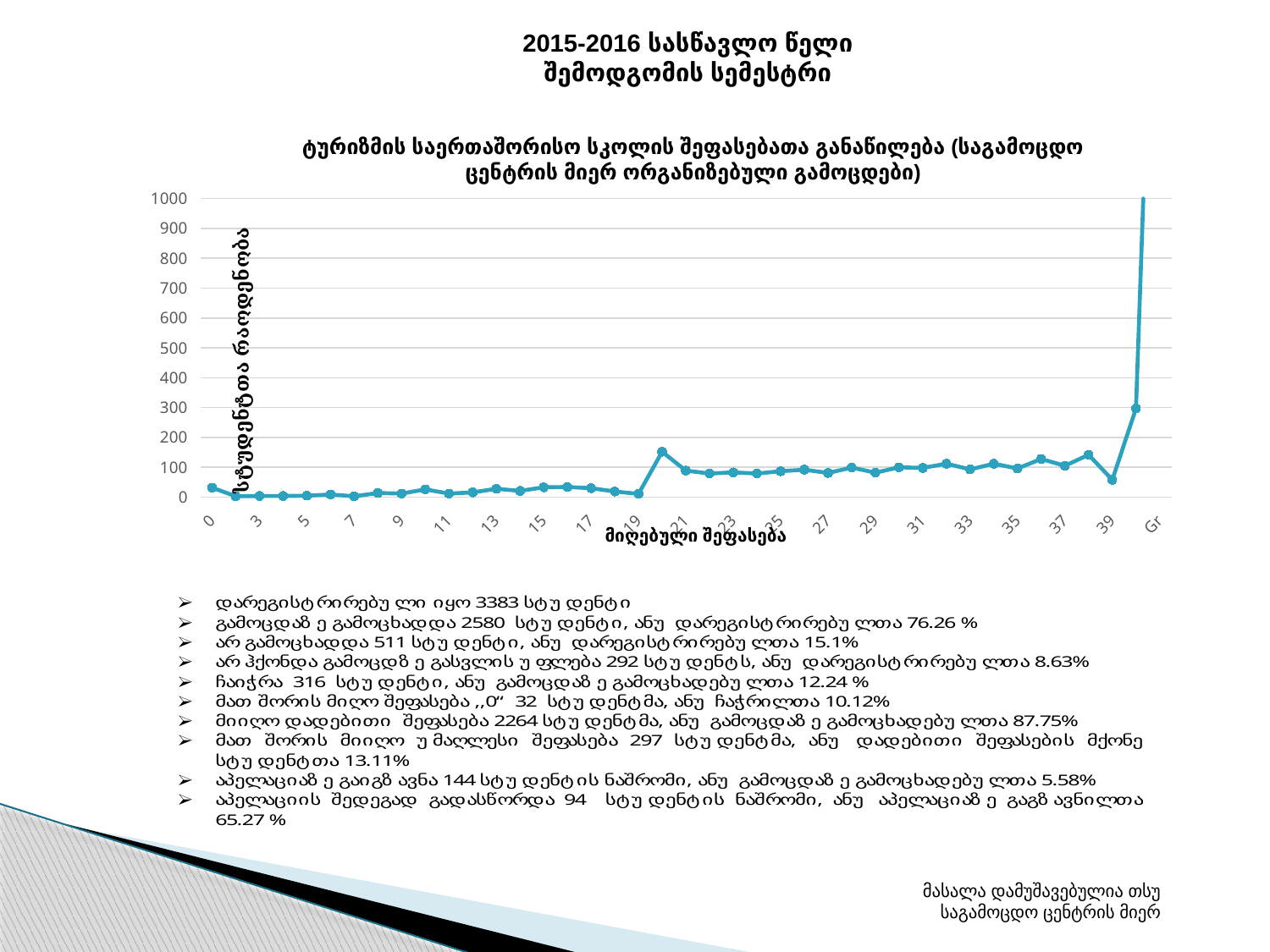
What is the label of the vertical axis of the chart? სტუდენტთა რაოდენობა Is the value for category 30 greater or less than 200? less What kind of chart is shown on the slide? line chart Which category on the x axis has the highest value? Gr What is the title of the chart? ტურიზმის საერთაშორისო სკოლის შეფასებათა განაწილება (საგამოცდო ცენტრის მიერ ორგანიზებული გამოცდები) Which has the larger value, category 38 or category 39? 38 Is the value for category 0 greater or less than 100? less Which has the larger value, category 19 or category 20? 20 Is the value for category 20 greater or less than 100? greater